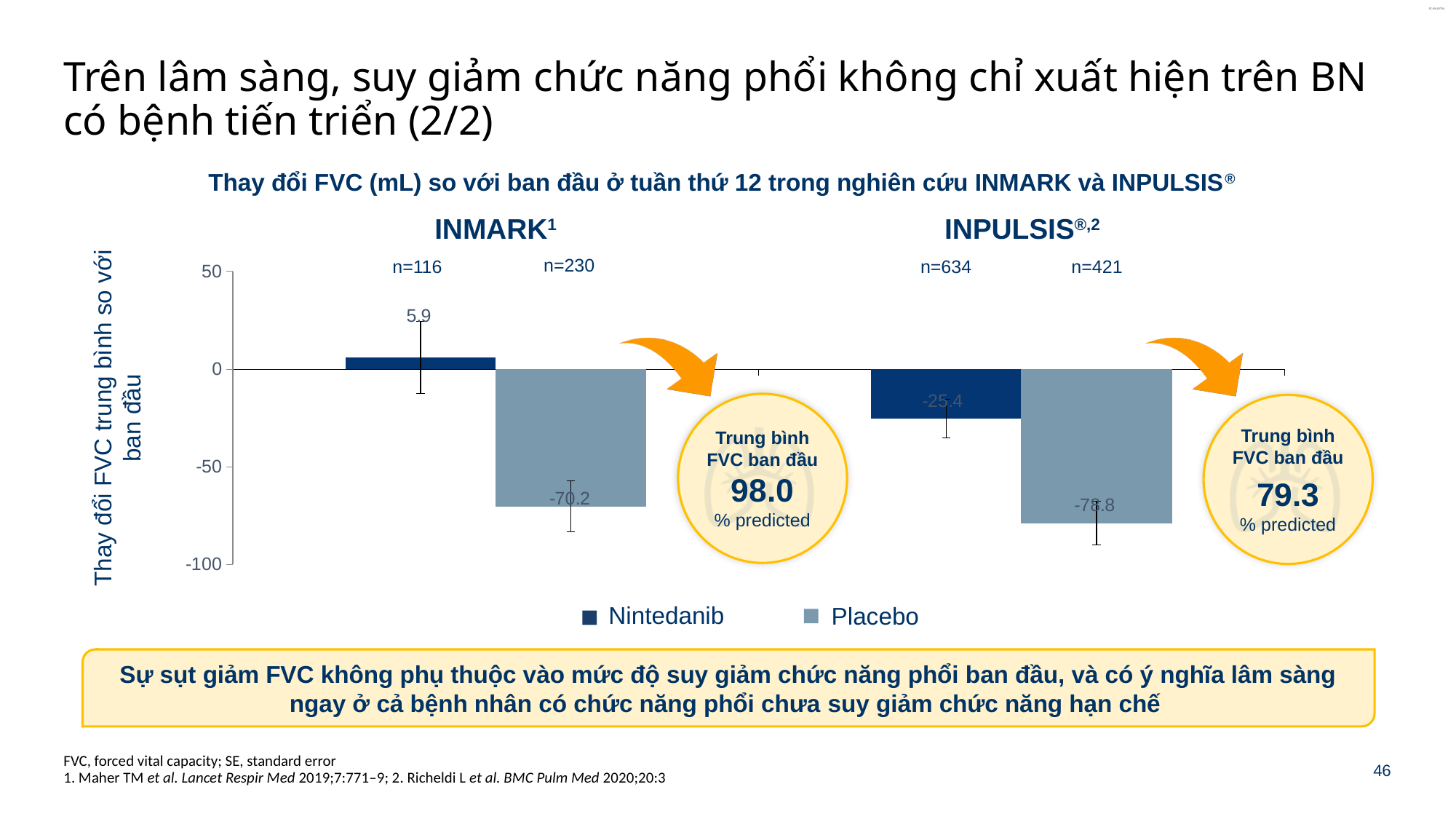
What is the n for the Nintedanib group in the INMARK study? n=116 What is the difference between the Nintedanib value in INMARK and the Nintedanib value in INPULSIS? 31.3 Is the value for Placebo in the INPULSIS study greater or less than -50? less What is the mean change in FVC for Placebo in the INMARK study? -70.2 In the INMARK study, which is larger: the value for Nintedanib or for Placebo? Nintedanib What is the mean change in FVC for Nintedanib in the INPULSIS study? -25.4 How many bars are plotted on the chart? 4 What is the mean change in FVC for Nintedanib in the INMARK study? 5.9 How many series does the legend list? 2 What is the difference between the Nintedanib and Placebo values in the INMARK study? 76.1 What kind of chart is shown on the slide? bar chart Which bar shows the lowest value on the chart? Placebo in INPULSIS